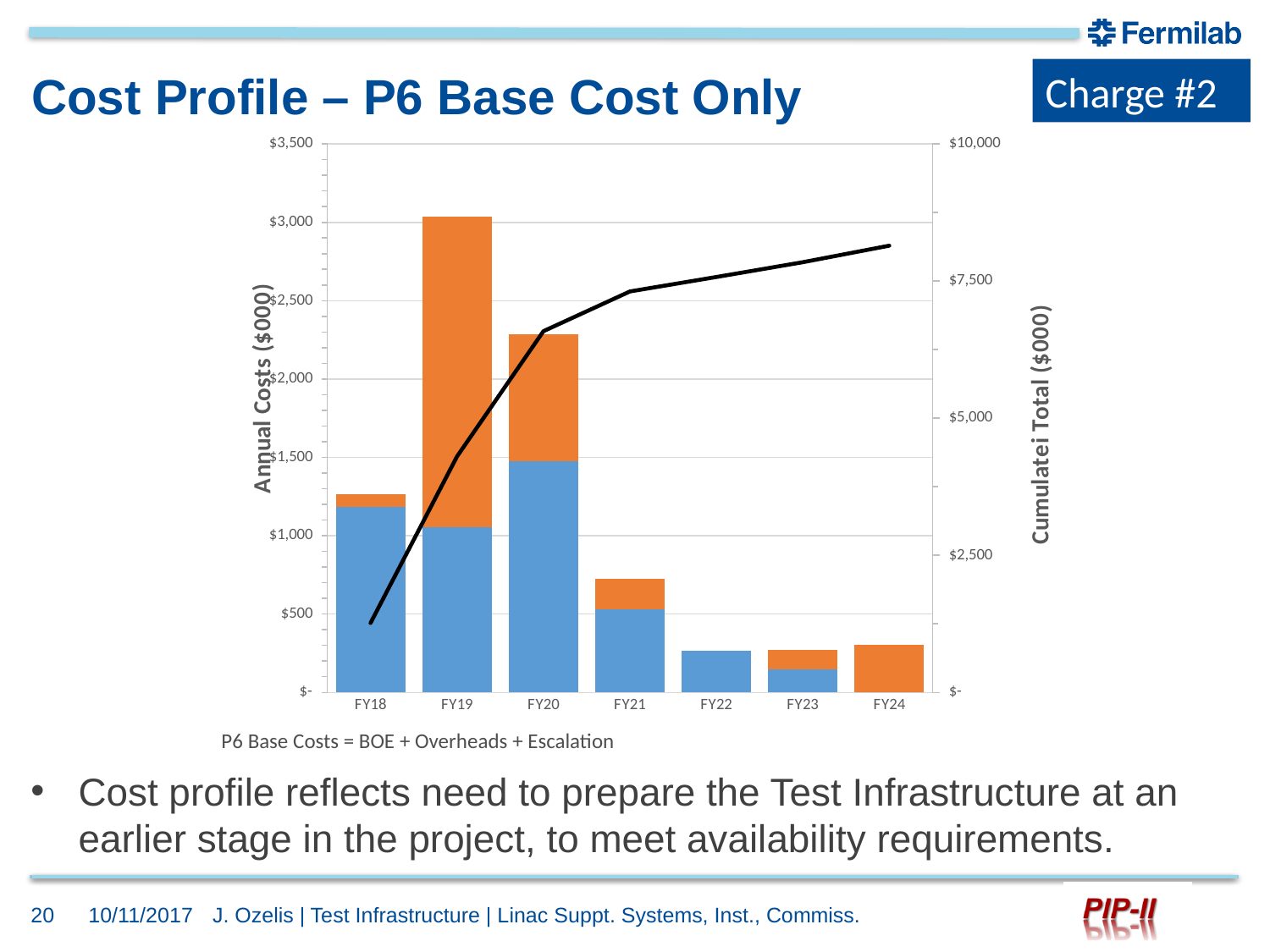
What kind of chart is used to show the annual costs? Bar chart (stacked bars with a cumulative line) Which has the larger total annual cost bar, FY18 or FY21? FY18 Is the total annual cost bar for FY18 greater or less than $1,000? greater How many fiscal years are shown on the x axis of the chart? 7 Which fiscal year has the tallest stacked bar for annual costs? FY19 Is the total annual cost bar for FY22 greater or less than $500? less Which has the larger total annual cost bar, FY19 or FY20? FY19 What is the title of the left vertical axis of the chart? Annual Costs ($000) Is the total annual cost bar for FY19 greater or less than $3,000? greater Does the cumulative total line rise or fall from FY18 to FY24? Rises